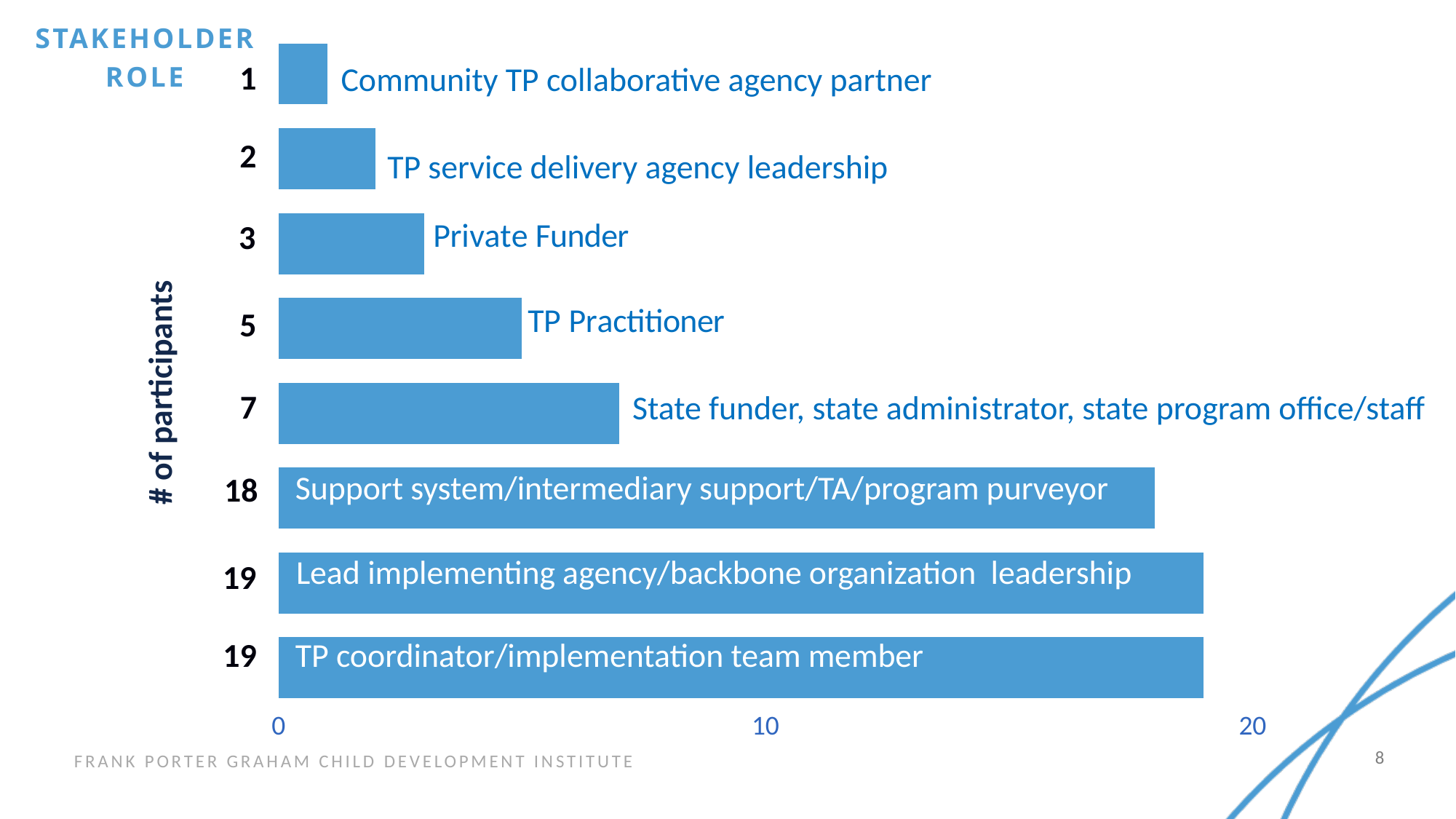
How many participants are in the Support system/intermediary support/TA/program purveyor role? 18 How many participants are in the State funder, state administrator, state program office/staff role? 7 What is the number of participants for the Private Funder role? 3 What is the label of the vertical axis? # of participants What is the title of the chart? STAKEHOLDER ROLE What kind of chart is shown on the slide? Bar chart How many participants are in the TP Practitioner role? 5 Which stakeholder role has the fewest participants? Community TP collaborative agency partner Which has more participants: TP Practitioner or Private Funder? TP Practitioner How many stakeholder roles are shown in the chart? 8 What is the difference in participants between the Lead implementing agency/backbone organization leadership role and the TP service delivery agency leadership role? 17 Is the value for the Support system/intermediary support/TA/program purveyor role greater or less than 10? greater